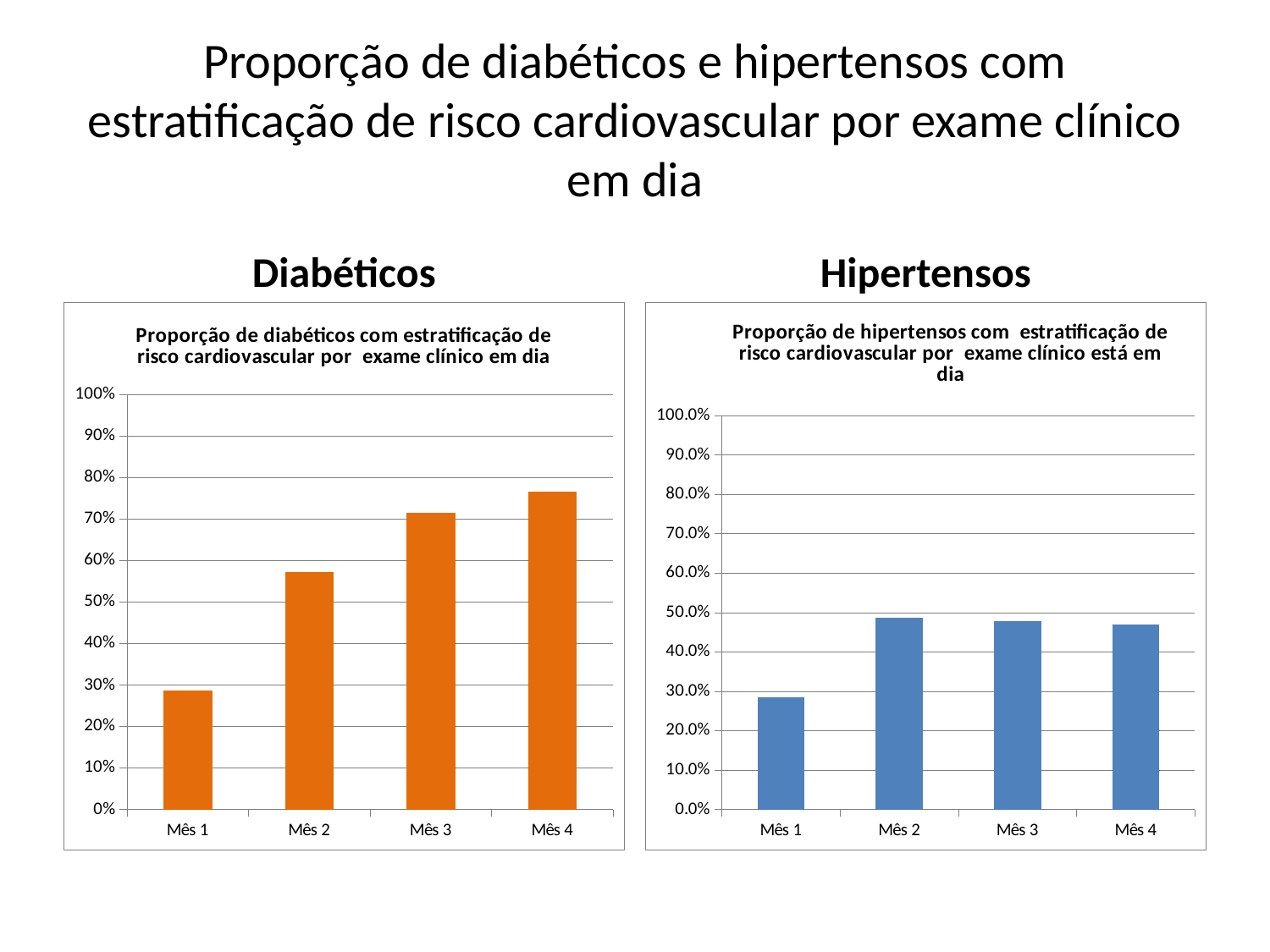
In the Hipertensos chart, is the value for Mês 4 greater or less than 40.0%? greater In the Diabéticos chart, is the value for Mês 1 greater or less than 30%? less How many categories (months) are shown on the Hipertensos chart on the right? 4 In the Hipertensos chart, which month has the lowest value? Mês 1 In the Hipertensos chart, is the value for Mês 1 greater or less than 30.0%? less What kind of chart is the Diabéticos chart on the left? bar chart In the Diabéticos chart, which is larger, the value for Mês 2 or Mês 3? Mês 3 In the Diabéticos chart, do the values rise or fall from Mês 1 to Mês 4? rise In the Diabéticos chart, which month has the lowest value? Mês 1 What colour are the bars in the Hipertensos chart? blue In the Diabéticos chart, which month has the highest value? Mês 4